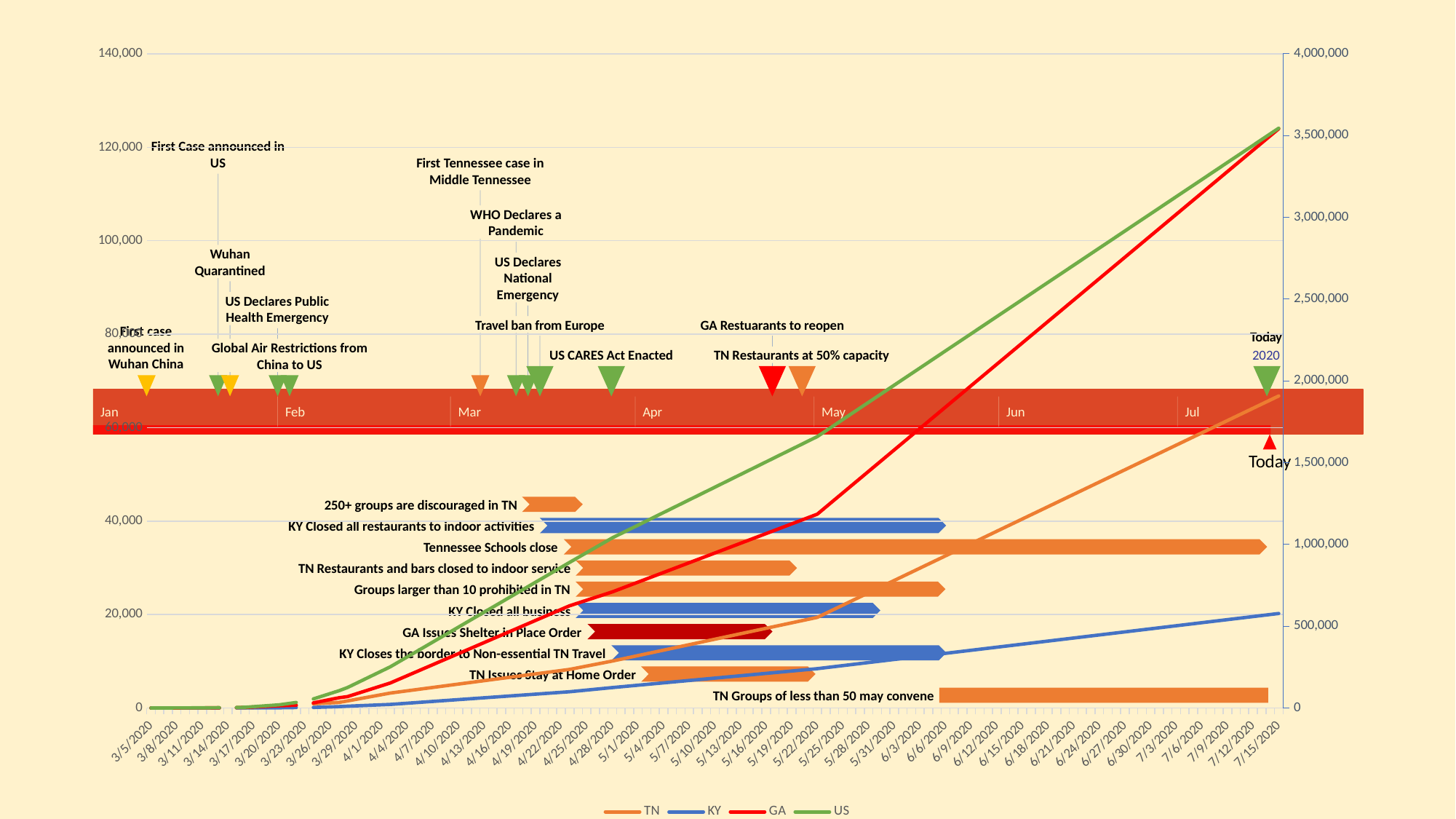
How many series does the legend list? 4 At 6/3/2020, which line is higher, GA or TN? GA Do the values for the TN series rise or fall along the x axis? rise Which series are listed in the legend? TN, KY, GA, US At 7/15/2020, which line is higher, TN or KY? TN What kind of chart is shown on the slide? line chart Which series has the lowest line at 7/15/2020? KY Do the values for the US series rise or fall from 3/5/2020 to 7/15/2020? rise What colour is the line for the KY series? blue At 7/15/2020, which line is higher, GA or KY? GA